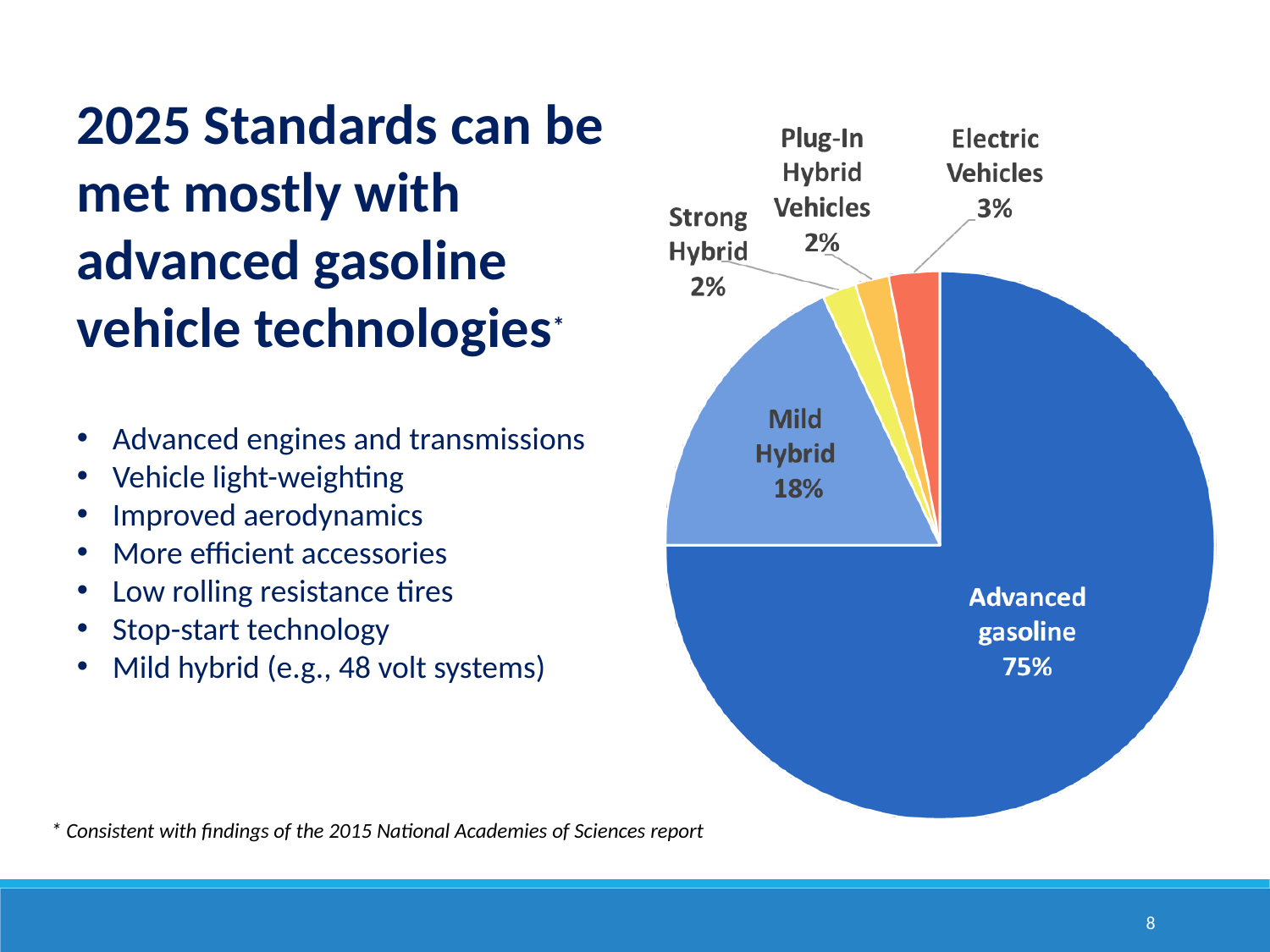
What is the difference between the Advanced gasoline and Mild Hybrid shares? 57% Which category has the largest slice of the pie? Advanced gasoline What is the value for Strong Hybrid? 2% What is the value for Plug-In Hybrid Vehicles? 2% What colour is the Electric Vehicles slice? red-orange What share of the pie does Advanced gasoline represent? 75% What is the combined share of Mild Hybrid and Electric Vehicles? 21% What kind of chart is shown on the slide? pie chart Which is larger, the share for Mild Hybrid or the share for Electric Vehicles? Mild Hybrid How many slices does the pie chart have? 5 What is the value for Mild Hybrid? 18% What is the value for Electric Vehicles? 3%